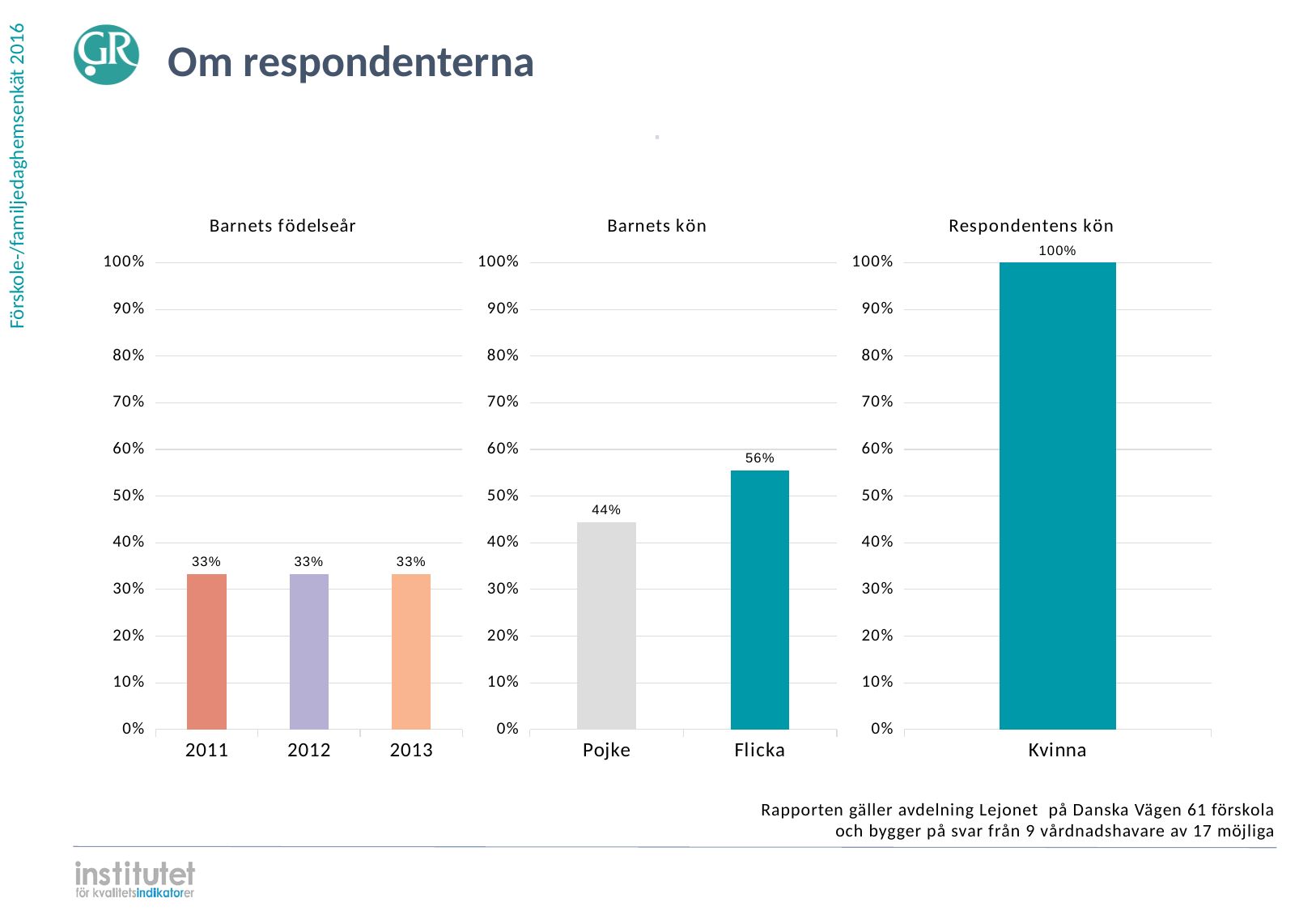
How many categories are shown in the 'Respondentens kön' chart? 1 In the 'Barnets kön' chart, which category has the highest value? Flicka What is the title of the chart on the right of the slide? Respondentens kön How many categories are shown in the 'Barnets födelseår' chart? 3 In the 'Barnets kön' chart, what is the difference between the values for Flicka and Pojke? 12% In the 'Barnets kön' chart, is the value for Pojke greater or less than 50%? less In the 'Barnets kön' chart, which category has the lowest value? Pojke In the 'Barnets kön' chart, what is the value for Pojke? 44% In the 'Barnets kön' chart, what is the value for Flicka? 56% In the 'Respondentens kön' chart, what is the value for Kvinna? 100% What kind of chart is the 'Barnets födelseår' chart? Bar chart In the 'Barnets födelseår' chart, what is the value for 2012? 33%